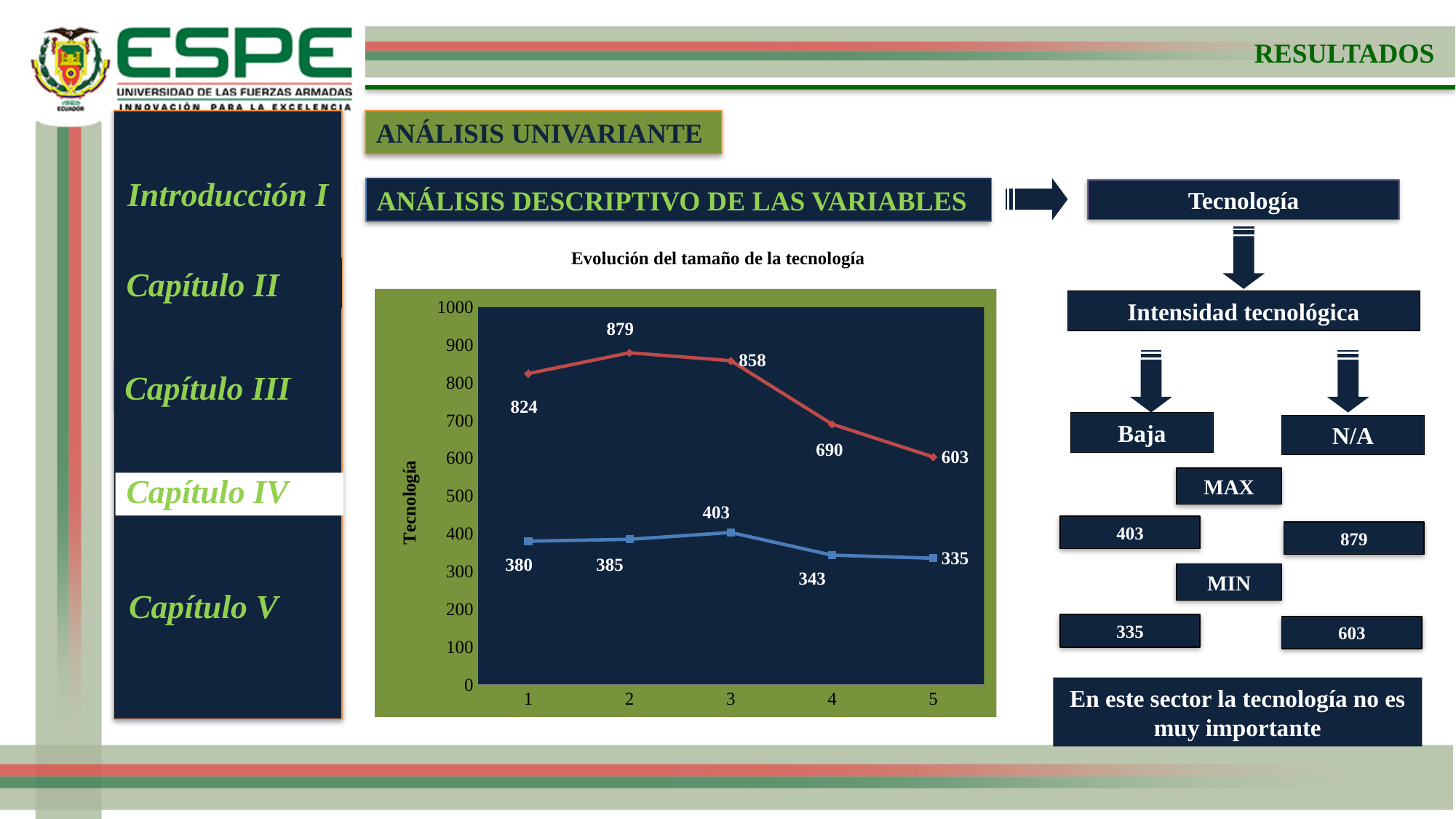
At which x value does the red line reach its highest point? 2 How many points are plotted along the x axis for each line? 5 Which is larger: the blue line's value at x = 2 or at x = 4? x = 2 What is the label on the vertical axis of the chart? Tecnología What is the difference between the red and blue line values at x = 3? 455 What is the value of the red line at x = 2? 879 What is the value of the red line at x = 5? 603 What is the value of the blue line at x = 3? 403 What type of chart is shown under the title "Evolución del tamaño de la tecnología"? line chart At which x value does the blue line reach its lowest point? 5 What is the difference between the red line's value at x = 1 and at x = 4? 134 Does the red line rise or fall from x = 3 to x = 5? fall